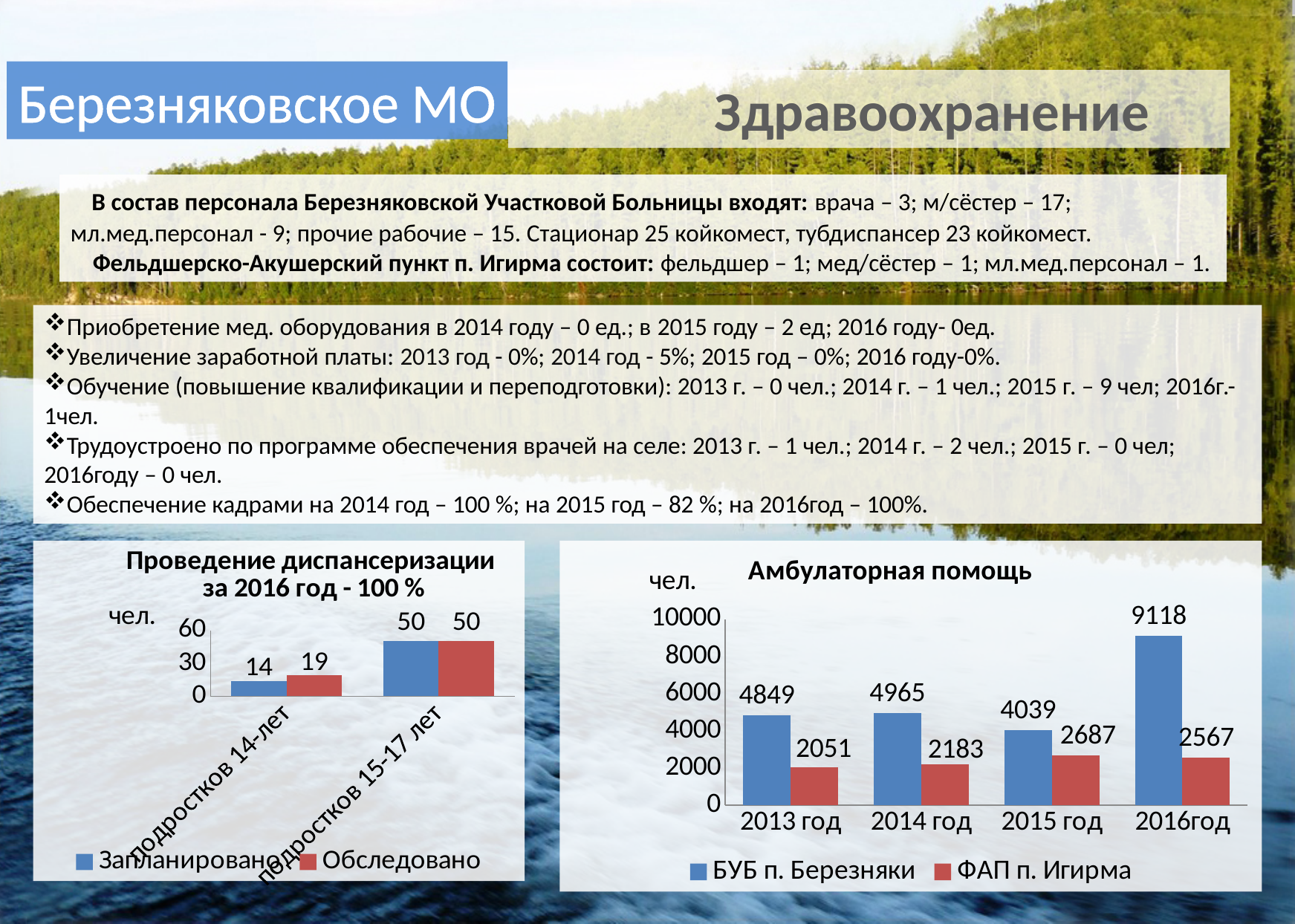
What type of chart is the 'Проведение диспансеризации за 2016 год - 100 %' chart? Bar chart In the 'Амбулаторная помощь' chart, what is the value for БУБ п. Березняки in 2016год? 9118 In the 'Амбулаторная помощь' chart, how many series does the legend list? 2 In the 'Проведение диспансеризации за 2016 год - 100 %' chart, what is the Обследовано value for подростков 14-лет? 19 In the 'Амбулаторная помощь' chart, which is larger: ФАП п. Игирма in 2015 год or in 2016год? 2015 год In the 'Амбулаторная помощь' chart, what is the value for ФАП п. Игирма in 2014 год? 2183 In the 'Амбулаторная помощь' chart, which year has the highest value for БУБ п. Березняки? 2016год In the 'Проведение диспансеризации за 2016 год - 100 %' chart, what is the difference between Обследовано and Запланировано for подростков 14-лет? 5 In the 'Амбулаторная помощь' chart, which year has the lowest value for ФАП п. Игирма? 2013 год In the 'Амбулаторная помощь' chart, how many years are shown on the x axis? 4 In the 'Проведение диспансеризации за 2016 год - 100 %' chart, what is the Запланировано value for подростков 15-17 лет? 50 In the 'Амбулаторная помощь' chart, what is the difference between БУБ п. Березняки and ФАП п. Игирма in 2015 год? 1352